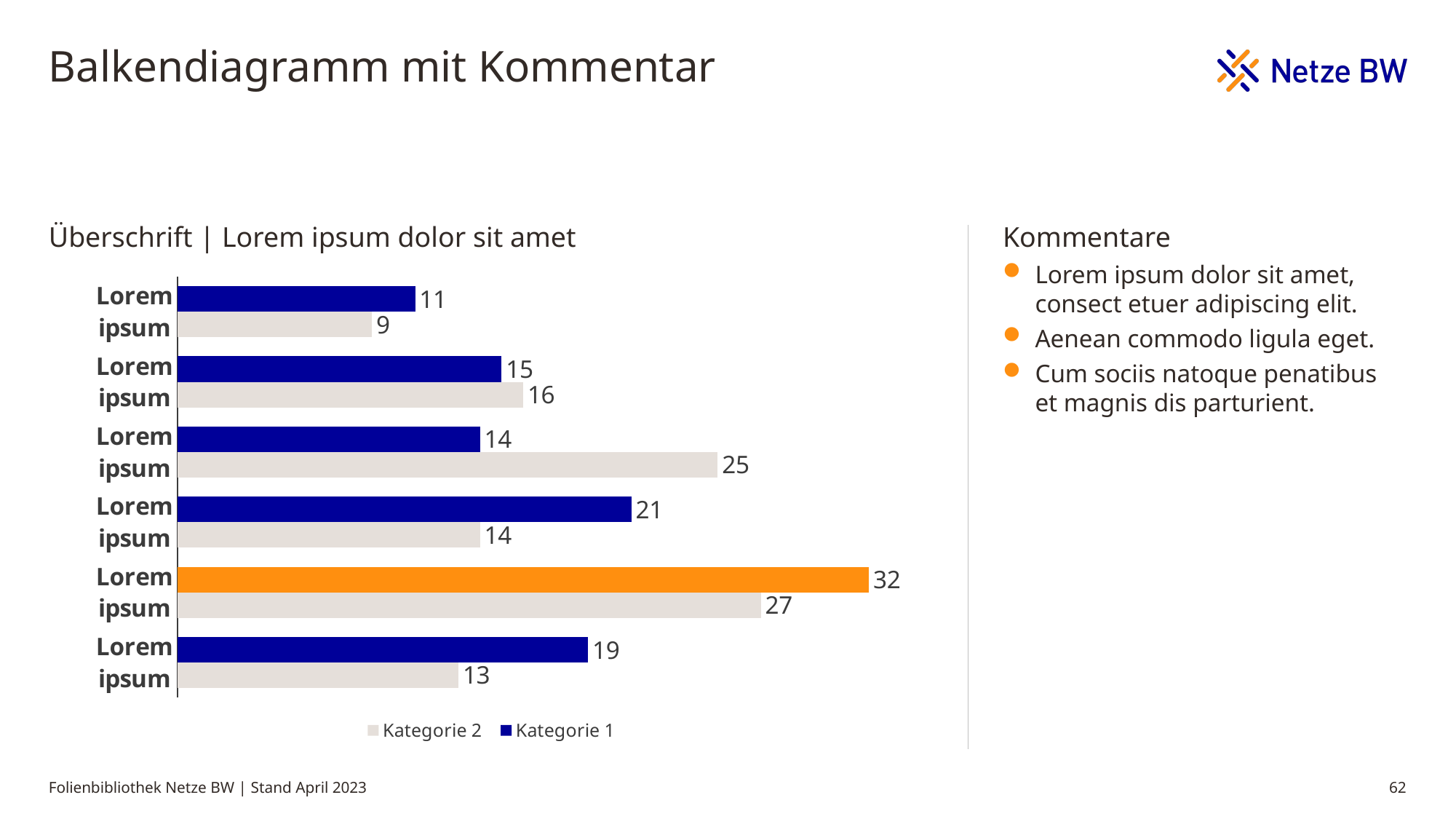
What kind of chart is shown on the slide? bar chart For the fifth category from the top, what is the difference between the Kategorie 1 and Kategorie 2 values? 5 How many series does the chart legend list? 2 What is the lowest Kategorie 2 value shown on the chart? 9 What is the Kategorie 2 value for the bottom category? 13 Which colour is used to highlight the single Kategorie 1 bar with the value 32? orange What is the highest Kategorie 2 value shown on the chart? 27 How many categories are plotted on the chart? 6 What are the two series names listed in the legend? Kategorie 2 and Kategorie 1 What is the highest Kategorie 1 value shown on the chart? 32 What is the Kategorie 1 value for the topmost category? 11 For the third category from the top, which series has the larger value, Kategorie 1 or Kategorie 2? Kategorie 2